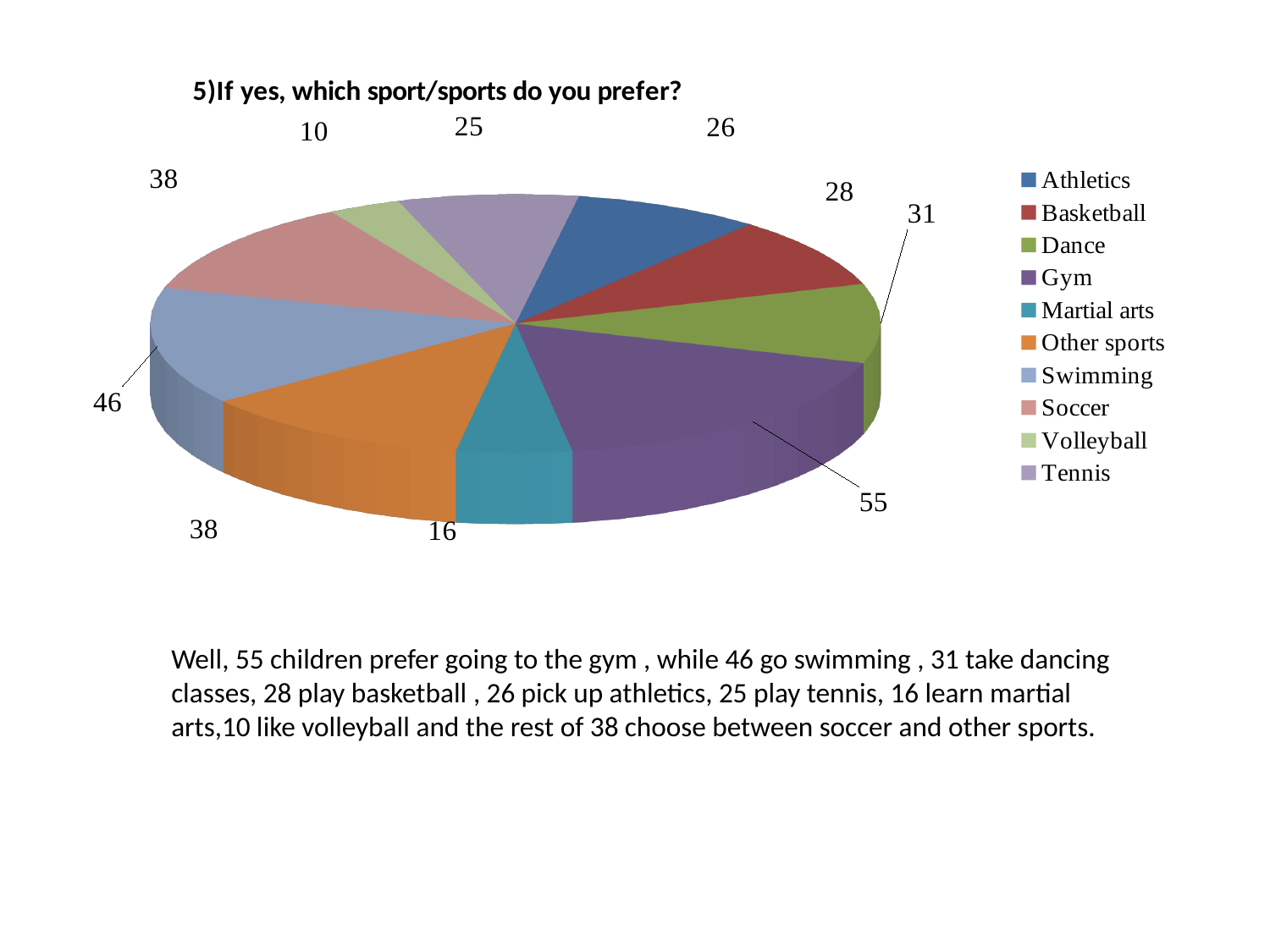
Which sport has the smallest slice in the pie chart? Volleyball What is the difference between the values for Gym and Swimming? 9 What value is shown for Martial arts in the pie chart? 16 What is the title of the chart? 5)If yes, which sport/sports do you prefer? How many sport categories are shown in the pie chart? 10 What value is shown for Gym in the pie chart? 55 What value is shown for Tennis in the pie chart? 25 Which has a larger value, Dance or Basketball? Dance What value is shown for Swimming in the pie chart? 46 Which sport has the largest slice in the pie chart? Gym What is the total of all the values shown in the pie chart? 313 What kind of chart is shown on the slide? Pie chart